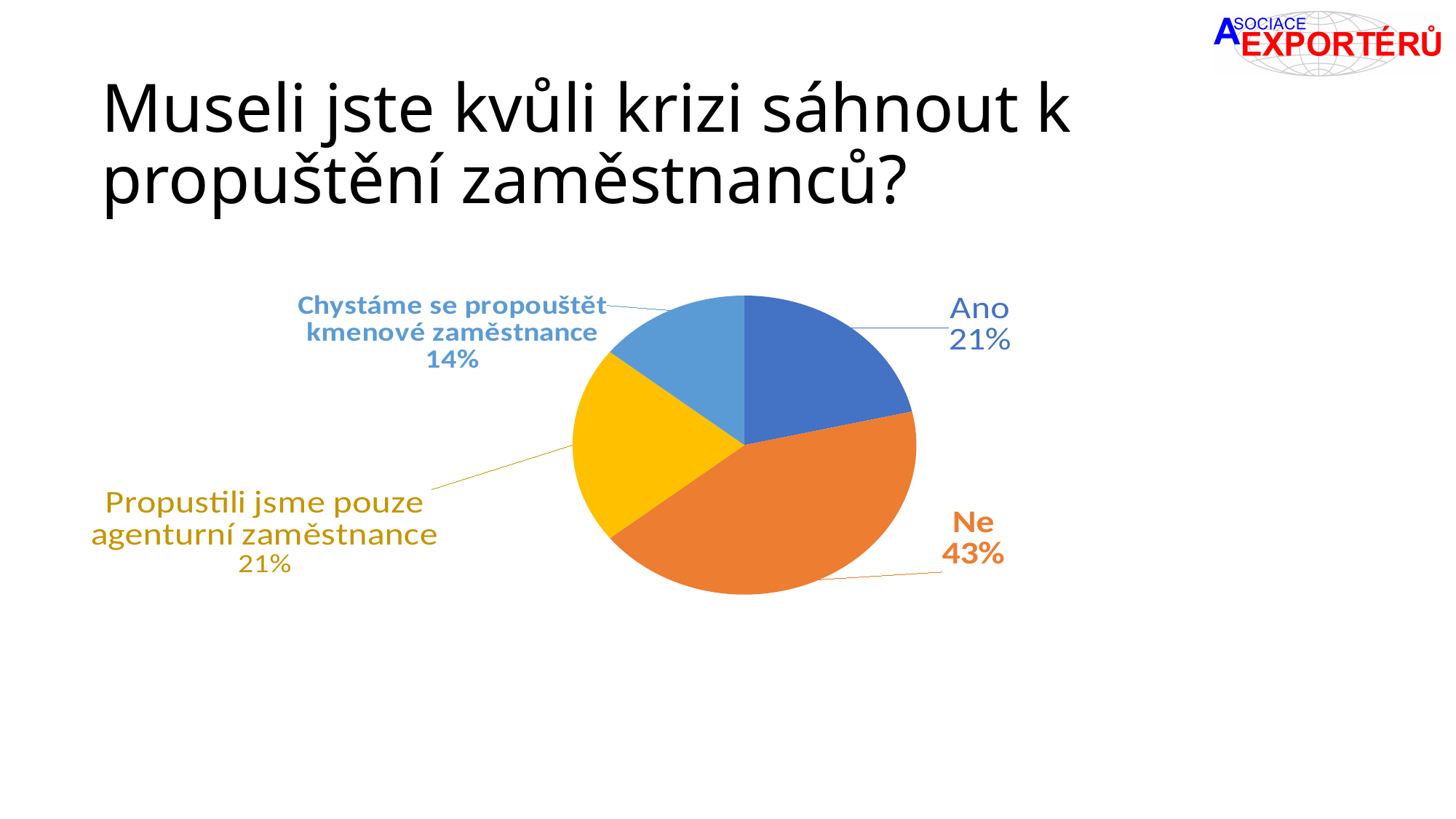
What type of chart is shown on the slide? pie chart What share of the pie does the "Ano" slice represent? 21% What share of the pie does the "Propustili jsme pouze agenturní zaměstnance" slice represent? 21% Which slice of the pie is the largest? Ne What colour is the "Ne" slice of the pie? orange What is the difference in percentage points between the "Propustili jsme pouze agenturní zaměstnance" slice and the "Chystáme se propouštět kmenové zaměstnance" slice? 7 What is the difference in percentage points between the "Ne" slice and the "Ano" slice? 22 How many slices does the pie chart have? 4 What share of the pie does the "Chystáme se propouštět kmenové zaměstnance" slice represent? 14% Which is larger, the "Ano" slice or the "Chystáme se propouštět kmenové zaměstnance" slice? Ano Which slice of the pie is the smallest? Chystáme se propouštět kmenové zaměstnance